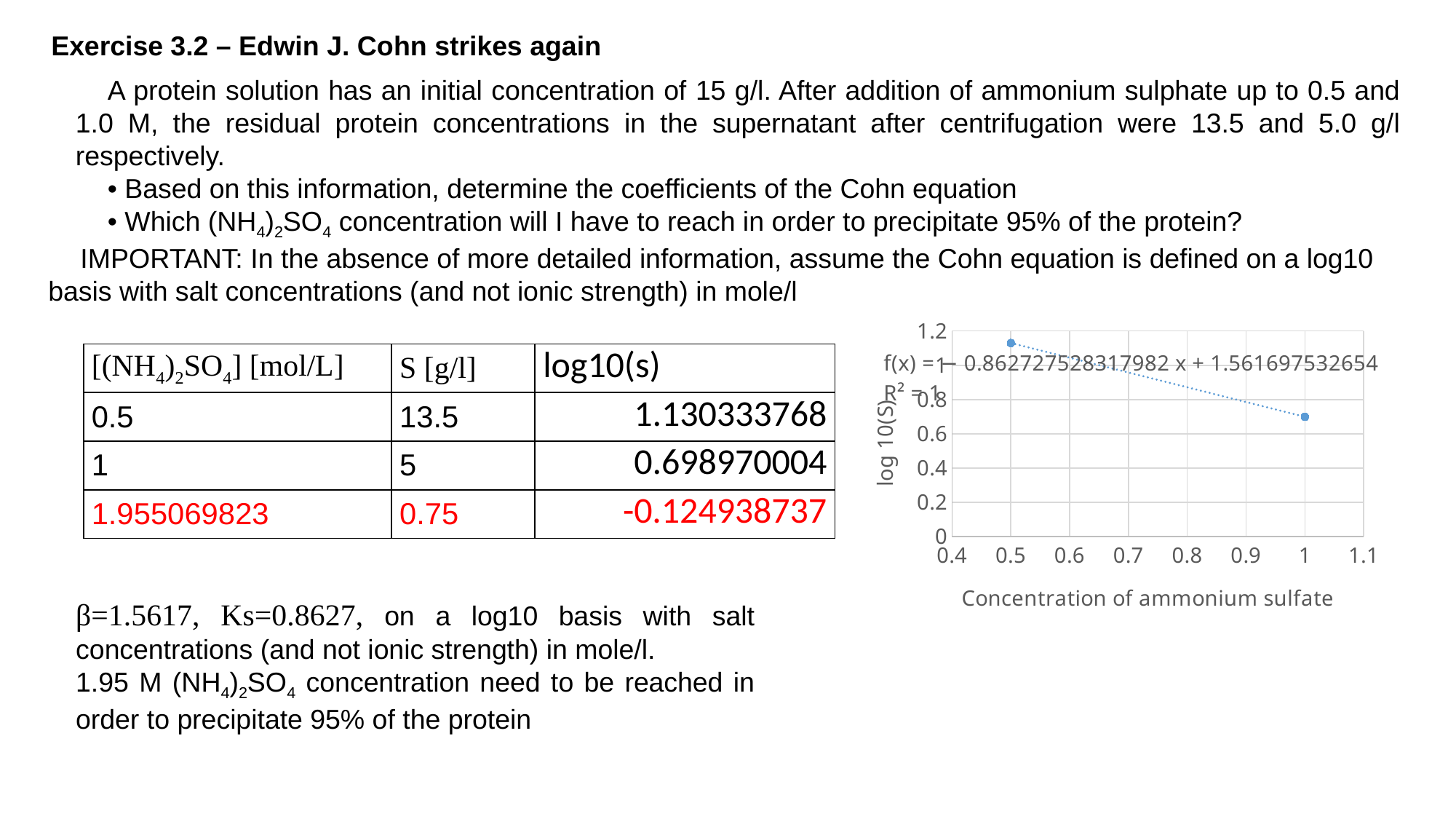
What is the title of the x axis of the chart? Concentration of ammonium sulfate What is the lowest concentration of ammonium sulfate at which a point is plotted? 0.5 Is the log 10(S) value at a concentration of 1 greater or less than 0.8? less What kind of chart is shown on the slide? scatter chart What is the slope of the trendline equation shown on the chart? -0.862727528317982 What is the highest concentration of ammonium sulfate at which a point is plotted? 1 Is the log 10(S) value at a concentration of 0.5 greater or less than 1? greater Which plotted point has the higher log 10(S) value, the one at concentration 0.5 or the one at concentration 1? 0.5 What is the R² value shown on the chart? 1 Do the plotted values rise or fall as the concentration of ammonium sulfate increases? fall How many data points are plotted in the chart? 2 What is the intercept of the trendline equation shown on the chart? 1.561697532654